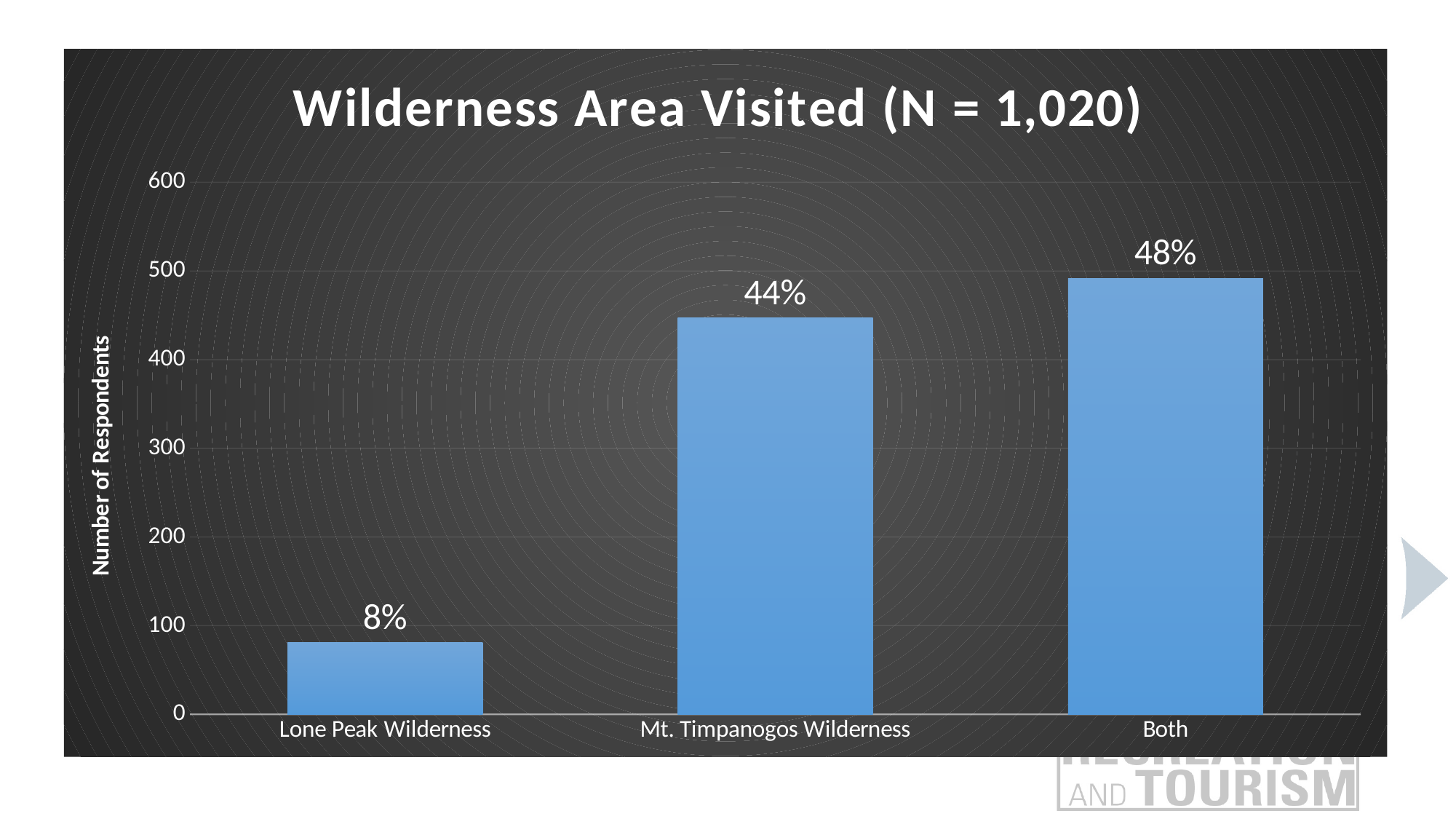
What is the data label shown on the bar for Lone Peak Wilderness? 8% What is the data label shown on the bar for Both? 48% How many categories are shown on the x axis? 3 What is the title of the chart? Wilderness Area Visited (N = 1,020) Is the number of respondents for Mt. Timpanogos Wilderness greater or less than 400? greater Which is larger, the value for Mt. Timpanogos Wilderness or the value for Lone Peak Wilderness? Mt. Timpanogos Wilderness What kind of chart is shown on the slide? Bar chart Which category has the highest bar? Both What is the data label shown on the bar for Mt. Timpanogos Wilderness? 44% Which category has the lowest bar? Lone Peak Wilderness What is the difference in percentage points between the labels for Both and Mt. Timpanogos Wilderness? 4 percentage points Is the number of respondents for Lone Peak Wilderness greater or less than 100? less